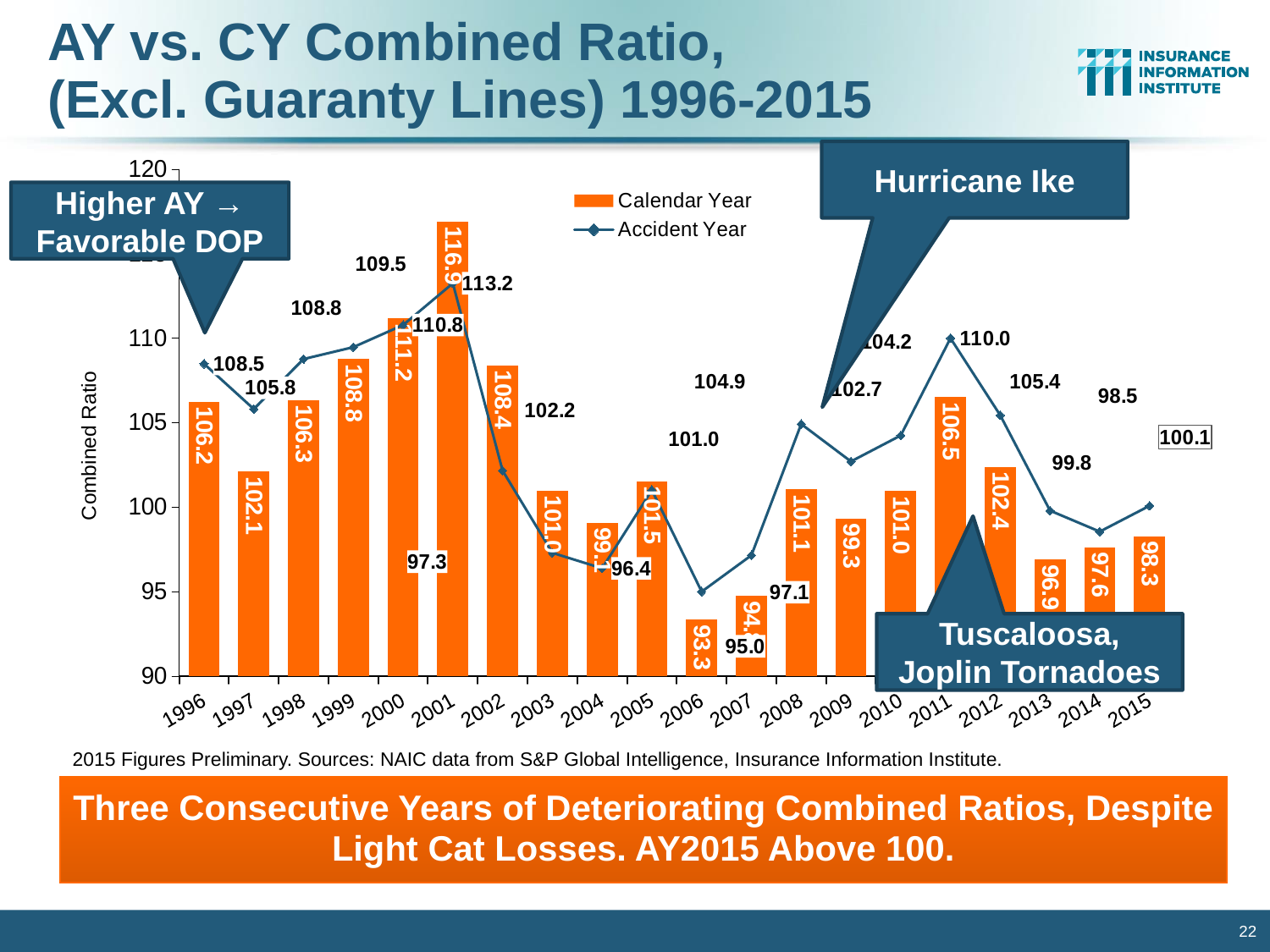
How many years are shown on the x axis? 20 What is the Accident Year combined ratio for 2001? 113.2 Which year has the highest Calendar Year combined ratio? 2001 What is the Calendar Year combined ratio for 2001? 116.9 What kind of chart is shown on the slide? A bar chart with a line series overlaid Do the Calendar Year combined ratios rise or fall from 2013 to 2015? Rise In 2011, which is larger: the Calendar Year or the Accident Year combined ratio? Accident Year Which year has the lowest Calendar Year combined ratio? 2006 What is the Accident Year combined ratio for 2015? 100.1 How many series does the legend list? 2 What are the two series named in the legend? Calendar Year and Accident Year What is the difference between the Calendar Year and Accident Year combined ratios in 2001? 3.7